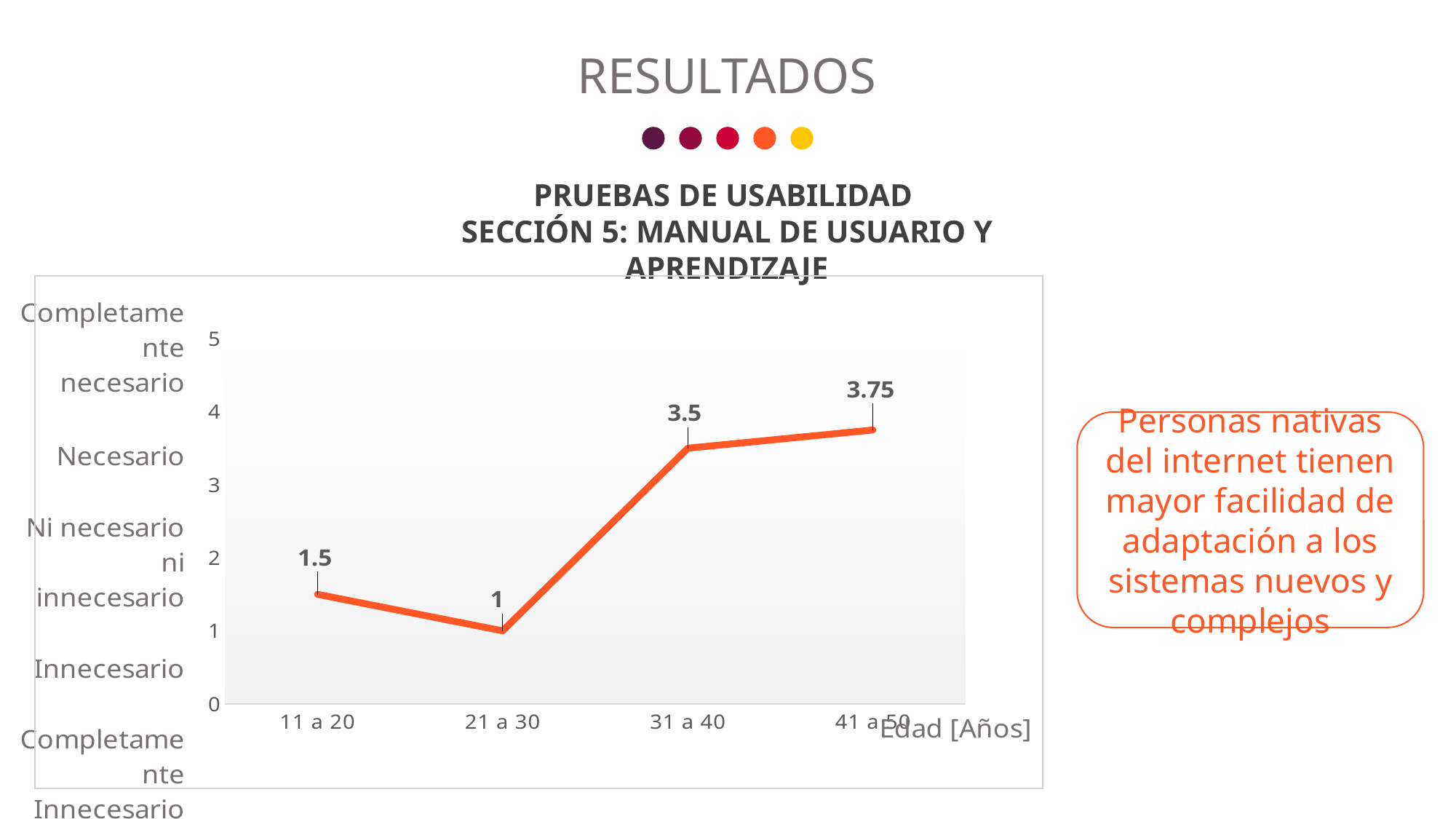
What is the difference between the values for 31 a 40 and 11 a 20? 2 Which age group has the lowest value? 21 a 30 What is the value for the 41 a 50 age group? 3.75 What is the label of the x axis? Edad [Años] Which age group has the highest value? 41 a 50 What kind of chart is shown on the slide? Line chart What is the value for the 11 a 20 age group? 1.5 Which has a larger value, 21 a 30 or 31 a 40? 31 a 40 What is the value for the 31 a 40 age group? 3.5 What is the value for the 21 a 30 age group? 1 How many age groups are plotted on the x axis? 4 Does the value rise or fall from 21 a 30 to 41 a 50? Rise